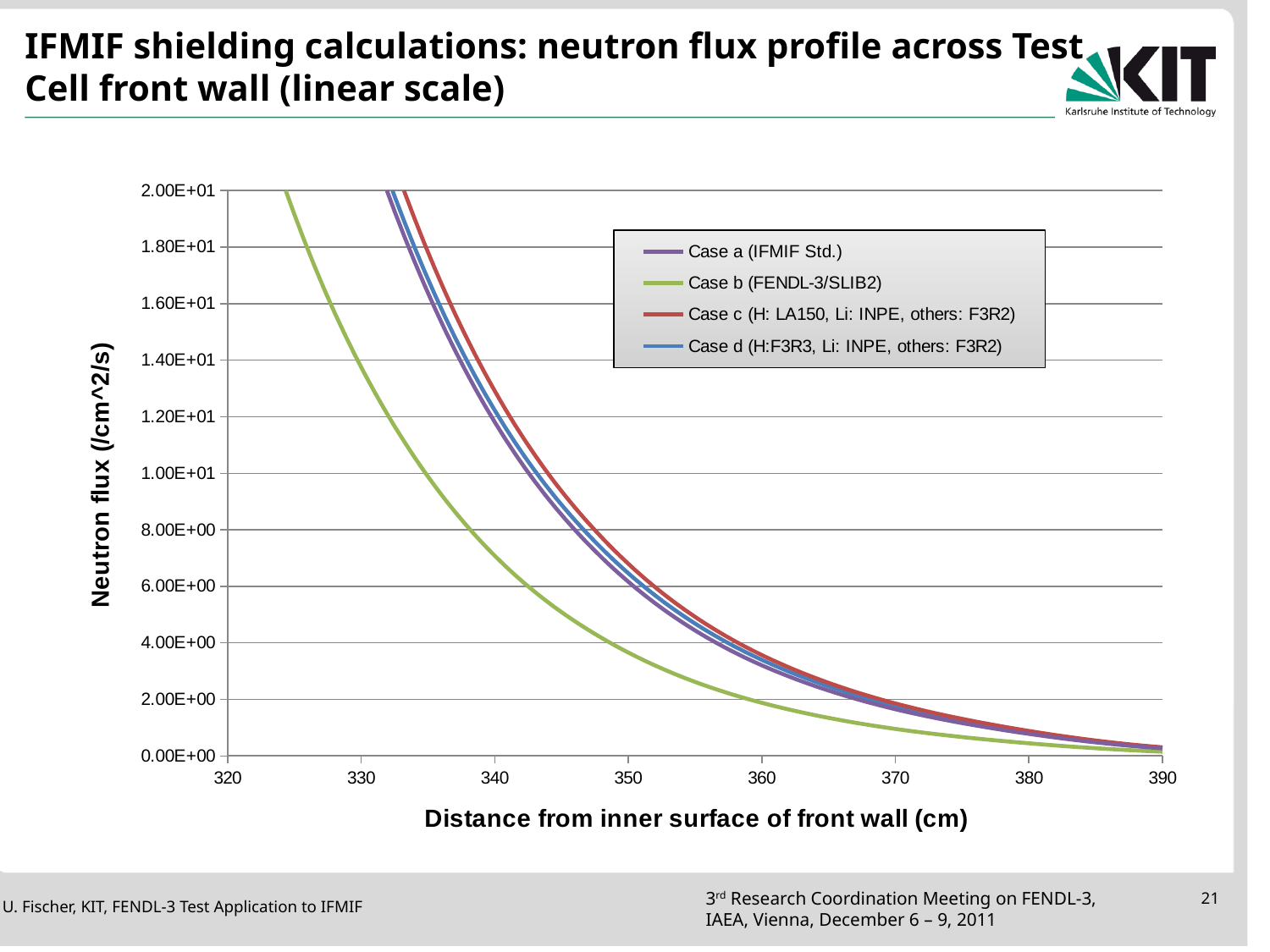
How many series does the legend list? 4 Does the neutron flux rise or fall as the distance from the inner surface of the front wall increases? fall What is the label of the x axis? Distance from inner surface of front wall (cm) Is the neutron flux for Case c (H: LA150, Li: INPE, others: F3R2) at 340 cm greater or less than 1.00E+01? greater At 340 cm, which has the larger neutron flux: Case b (FENDL-3/SLIB2) or Case c (H: LA150, Li: INPE, others: F3R2)? Case c (H: LA150, Li: INPE, others: F3R2) Is the neutron flux for Case b (FENDL-3/SLIB2) at 370 cm greater or less than 2.00E+00? less Which series is drawn in green? Case b (FENDL-3/SLIB2) Which series has the lowest neutron flux at 340 cm? Case b (FENDL-3/SLIB2) Is the neutron flux for Case a (IFMIF Std.) at 360 cm greater or less than 4.00E+00? less At 350 cm, which has the larger neutron flux: Case a (IFMIF Std.) or Case b (FENDL-3/SLIB2)? Case a (IFMIF Std.) What kind of chart is shown on the slide? line chart